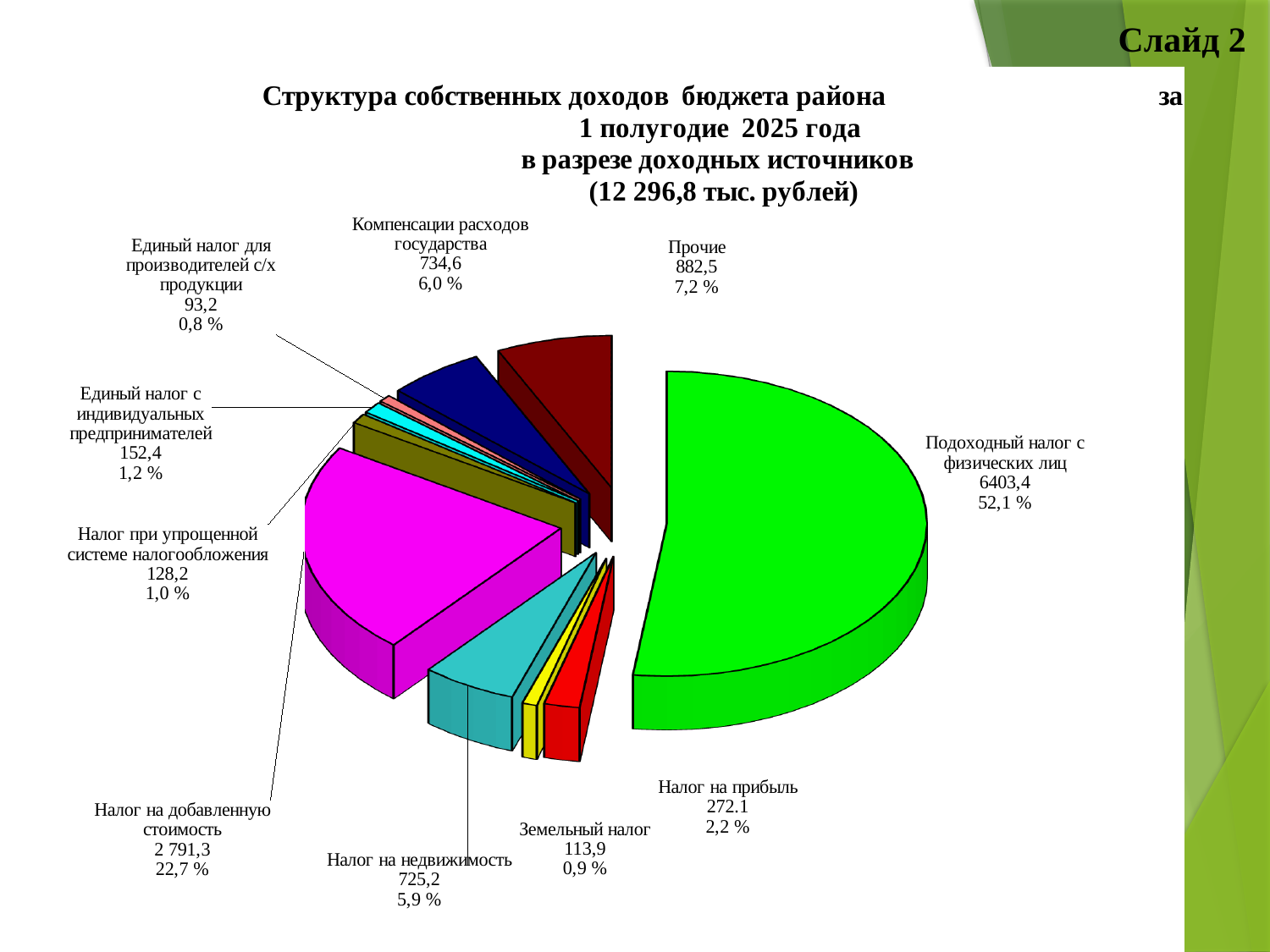
What total amount in thousand rubles is stated in the chart title? 12 296,8 тыс. рублей What is the value for Налог на добавленную стоимость? 2 791,3 Which category has the smallest value? Единый налог для производителей с/х продукции What is the value for Подоходный налог с физических лиц? 6403,4 What is the difference between the values for Прочие and Компенсации расходов государства? 147,9 How many categories (slices) does the pie chart show? 10 What share of the pie does Налог на недвижимость represent? 5,9 % Which is larger: the value for Единый налог с индивидуальных предпринимателей or the value for Налог при упрощенной системе налогообложения? Единый налог с индивидуальных предпринимателей Which category has the largest value? Подоходный налог с физических лиц What is the value for Земельный налог? 113,9 What kind of chart is shown on the slide? Pie chart What share of the pie does Подоходный налог с физических лиц represent? 52,1 %